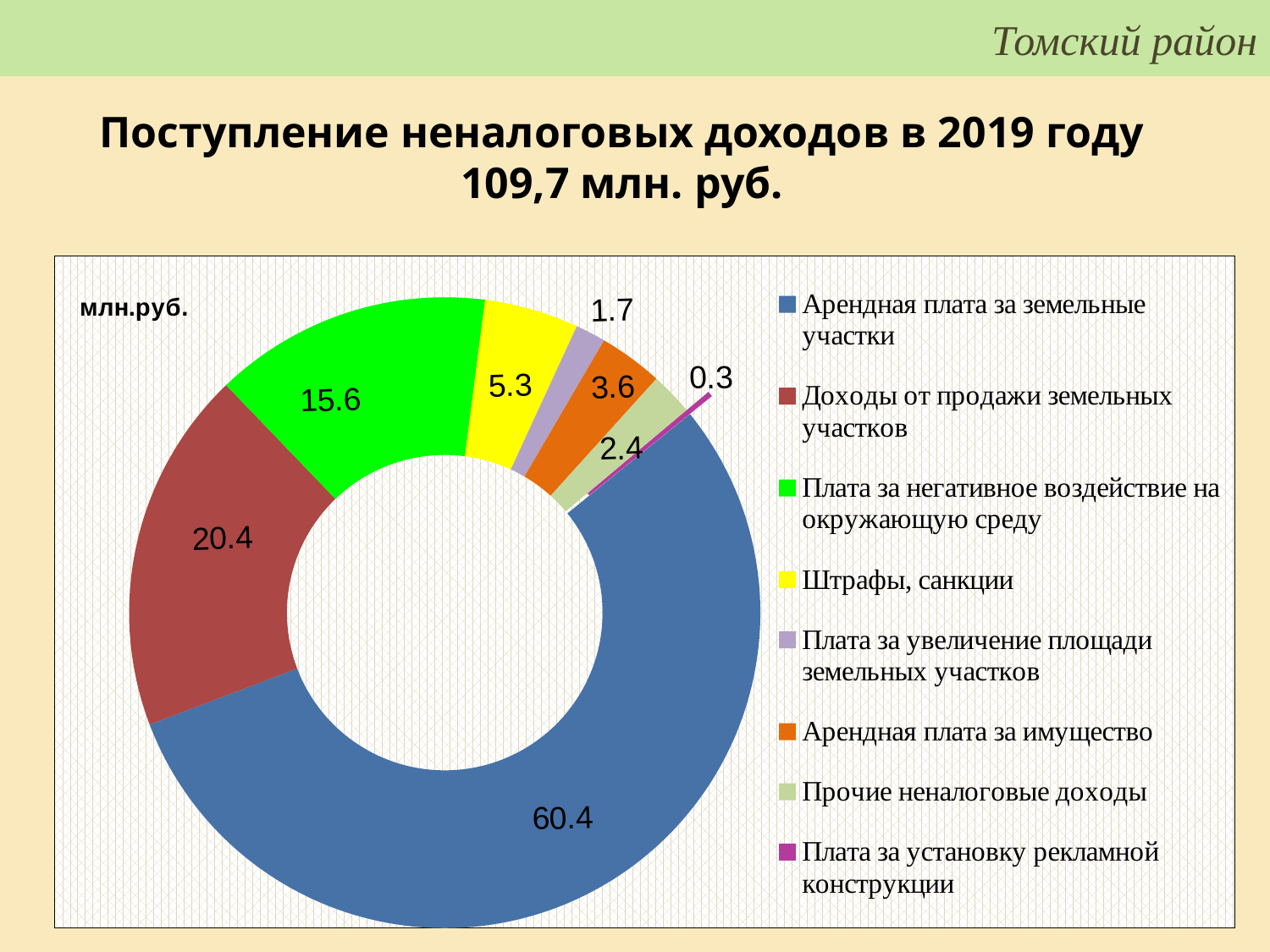
How many categories does the legend list? 8 What is the value for Доходы от продажи земельных участков? 20.4 What is the value for Арендная плата за земельные участки? 60.4 What is the value for Плата за установку рекламной конструкции? 0.3 Which category has the lowest value? Плата за установку рекламной конструкции What is the difference between Арендная плата за земельные участки and Доходы от продажи земельных участков? 40 Which is larger: Штрафы, санкции or Арендная плата за имущество? Штрафы, санкции What is the value for Штрафы, санкции? 5.3 What kind of chart is shown on the slide? doughnut chart What is the value for Плата за негативное воздействие на окружающую среду? 15.6 What is the difference between Арендная плата за имущество and Прочие неналоговые доходы? 1.2 Which category has the highest value? Арендная плата за земельные участки